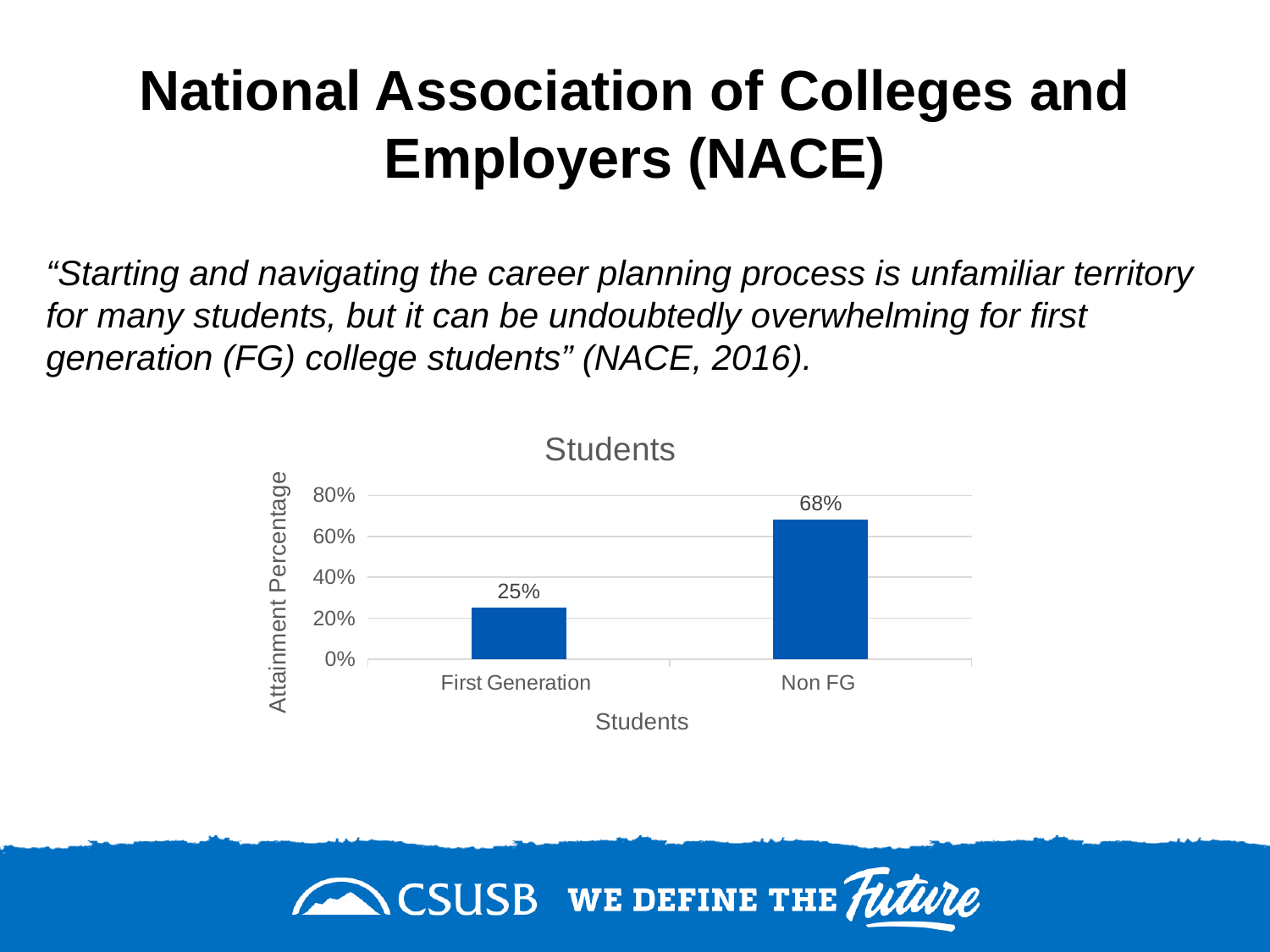
Is the value for Non FG greater or less than 60%? greater What kind of chart is shown on the slide? Bar chart How many categories are shown on the x axis of the chart? 2 What is the title of the chart? Students What is the difference in attainment percentage between Non FG and First Generation students? 43% Which category has the highest attainment percentage? Non FG What is the attainment percentage for First Generation students? 25% What is the label of the vertical axis of the chart? Attainment Percentage Which is larger, the attainment percentage for First Generation or for Non FG? Non FG Is the value for First Generation greater or less than 40%? less What is the attainment percentage for Non FG students? 68% Which category has the lowest attainment percentage? First Generation